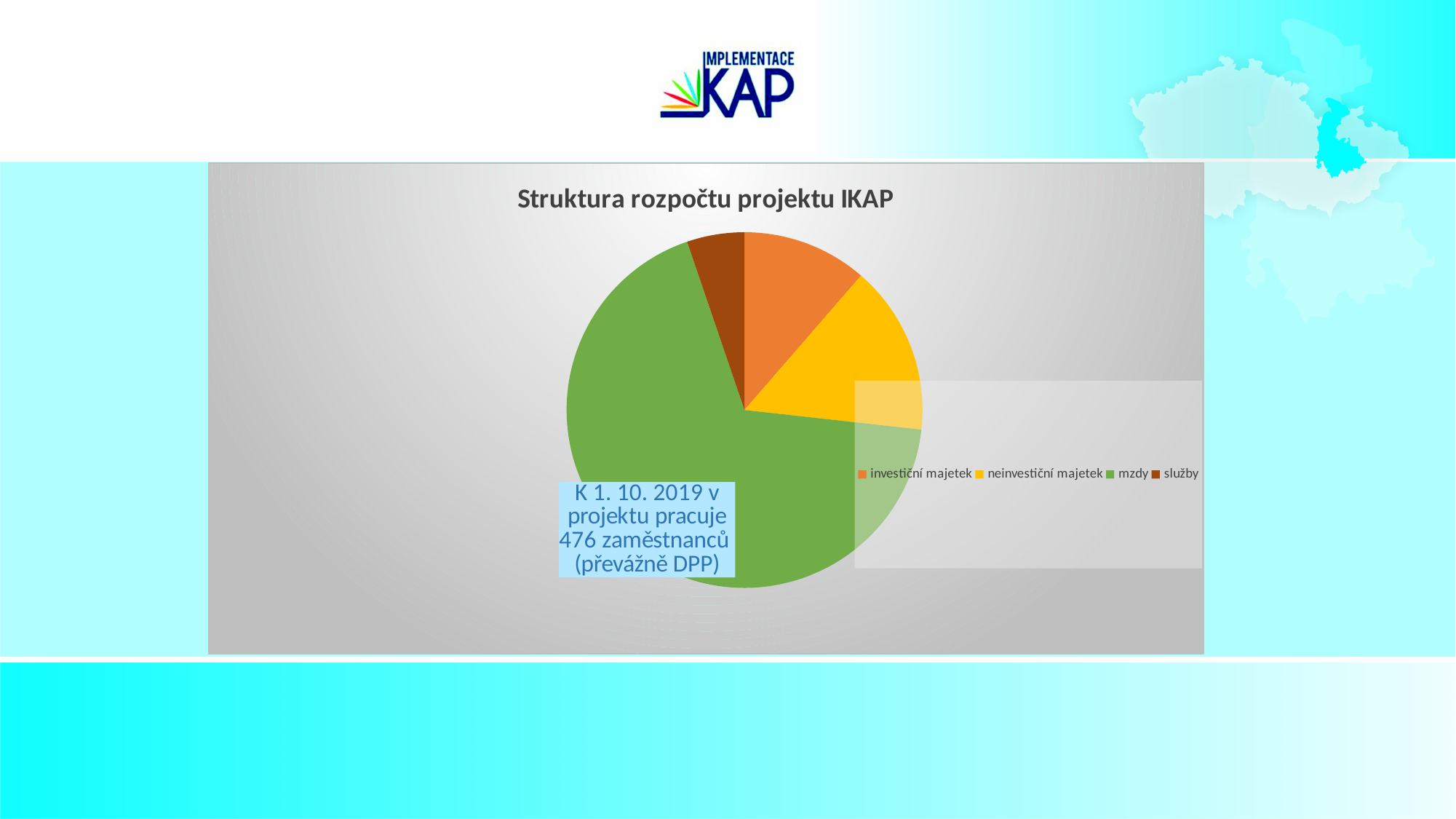
Which category has the smallest share of the pie? služby Which slice is larger, neinvestiční majetek or služby? neinvestiční majetek Which category has the largest share of the pie? mzdy What is the title of the chart? Struktura rozpočtu projektu IKAP How many entries does the chart legend list? 4 What kind of chart is shown on the slide? pie chart Which slice is larger, mzdy or neinvestiční majetek? mzdy Which colour represents mzdy in the pie chart? green Which slice is larger, mzdy or investiční majetek? mzdy How many slices does the pie chart have? 4